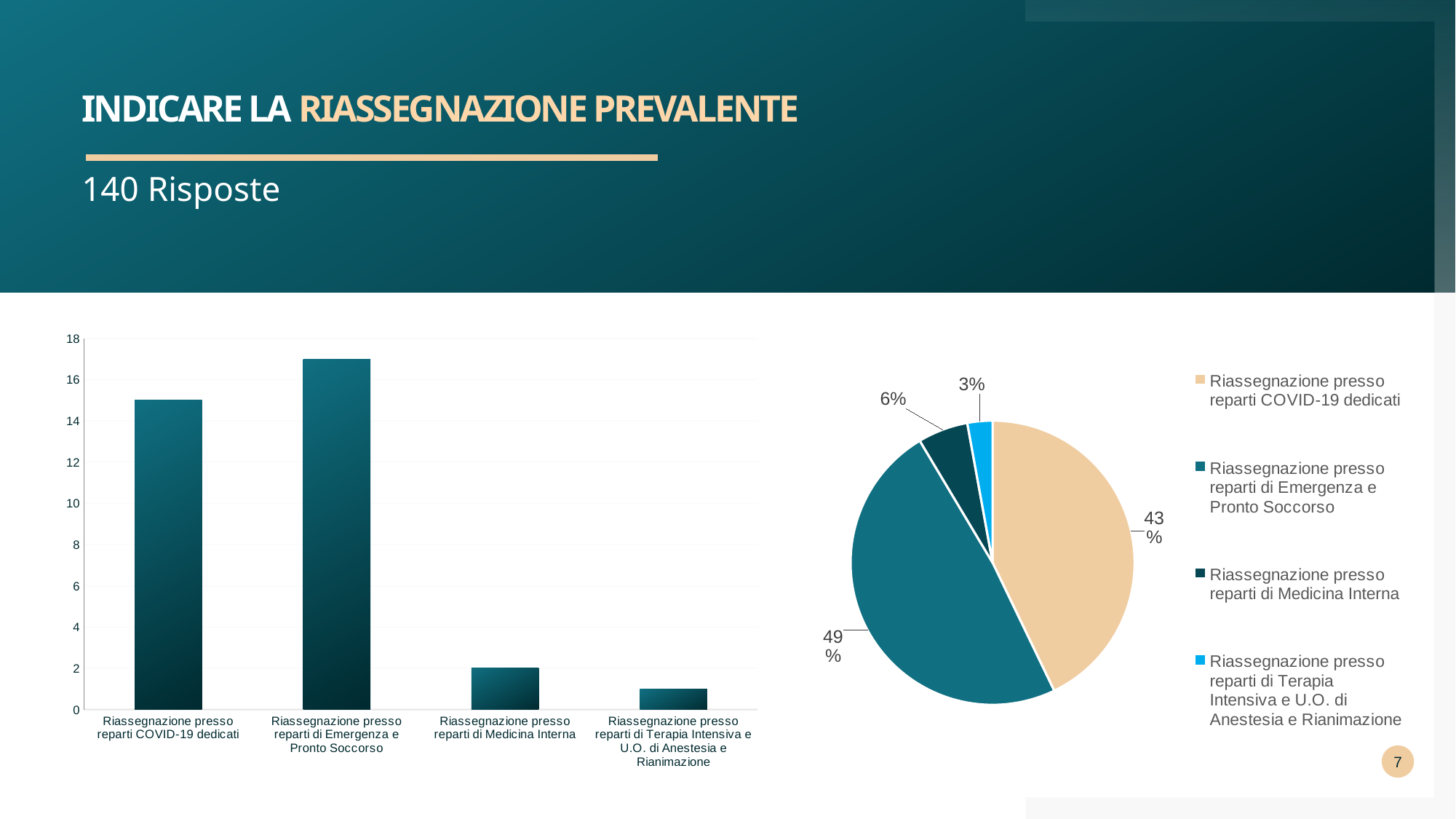
In the pie chart on the right, what share is shown for Riassegnazione presso reparti COVID-19 dedicati? 43% In the pie chart on the right, what is the difference between the share for Riassegnazione presso reparti di Medicina Interna and the share for Riassegnazione presso reparti di Terapia Intensiva e U.O. di Anestesia e Rianimazione? 3% In the bar chart on the left, which category has the highest bar? Riassegnazione presso reparti di Emergenza e Pronto Soccorso What kind of chart is the chart on the right of the slide? pie chart What kind of chart is the chart on the left of the slide? bar chart In the bar chart on the left, is the value for Riassegnazione presso reparti COVID-19 dedicati greater or less than 14? greater In the bar chart on the left, which category has the lowest bar? Riassegnazione presso reparti di Terapia Intensiva e U.O. di Anestesia e Rianimazione In the bar chart on the left, is the value for Riassegnazione presso reparti di Emergenza e Pronto Soccorso greater or less than 16? greater In the pie chart on the right, what share is shown for Riassegnazione presso reparti di Emergenza e Pronto Soccorso? 49% In the bar chart on the left, what is the value for Riassegnazione presso reparti di Medicina Interna? 2 How many entries does the legend of the pie chart on the right list? 4 In the bar chart on the left, how many categories are shown? 4